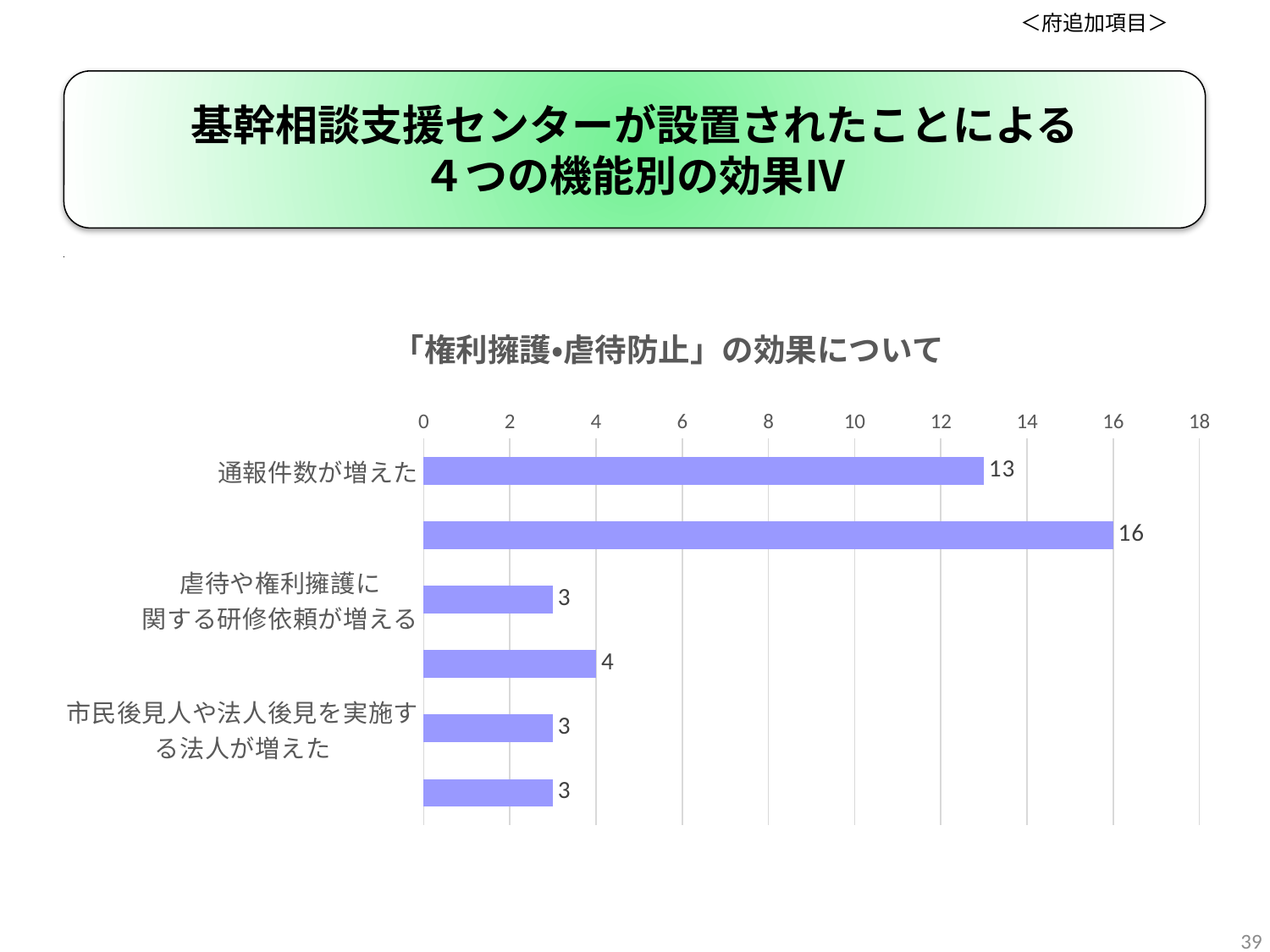
What is the value for 通報件数が増えた? 13 Which is larger, the value for 通報件数が増えた or the value for 市民後見人や法人後見を実施する法人が増えた? 通報件数が増えた What is the highest value shown on the chart? 16 What is the title of the chart? 「権利擁護•虐待防止」の効果について How many bars are plotted on the chart? 6 What is the value for 市民後見人や法人後見を実施する法人が増えた? 3 What is the lowest value shown on the chart? 3 What is the value for 虐待や権利擁護に関する研修依頼が増える? 3 Is the value for 通報件数が増えた greater or less than 10? greater What kind of chart is shown on the slide? bar chart What is the difference between the values for 通報件数が増えた and 虐待や権利擁護に関する研修依頼が増える? 10 What is the maximum value shown on the chart's axis? 18